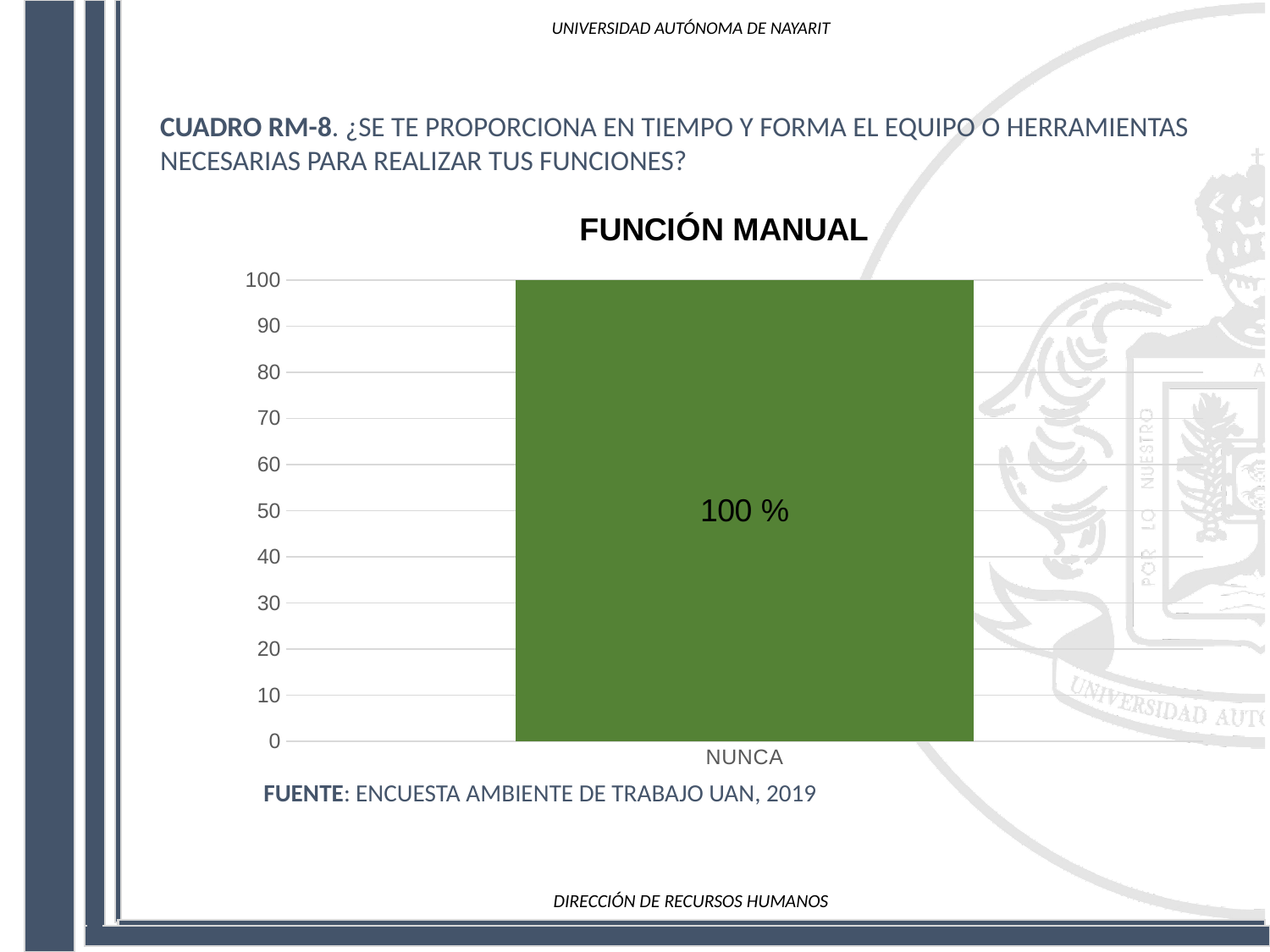
How many categories are plotted in the FUNCIÓN MANUAL chart? 1 Which category has the highest value in the chart? NUNCA What is the value shown for NUNCA in the FUNCIÓN MANUAL chart? 100 % What kind of chart is shown on the slide? bar chart Is the value for NUNCA greater or less than 50? greater What is the title of the chart? FUNCIÓN MANUAL What is the highest value shown on the vertical axis? 100 What is the label of the only category on the x axis? NUNCA